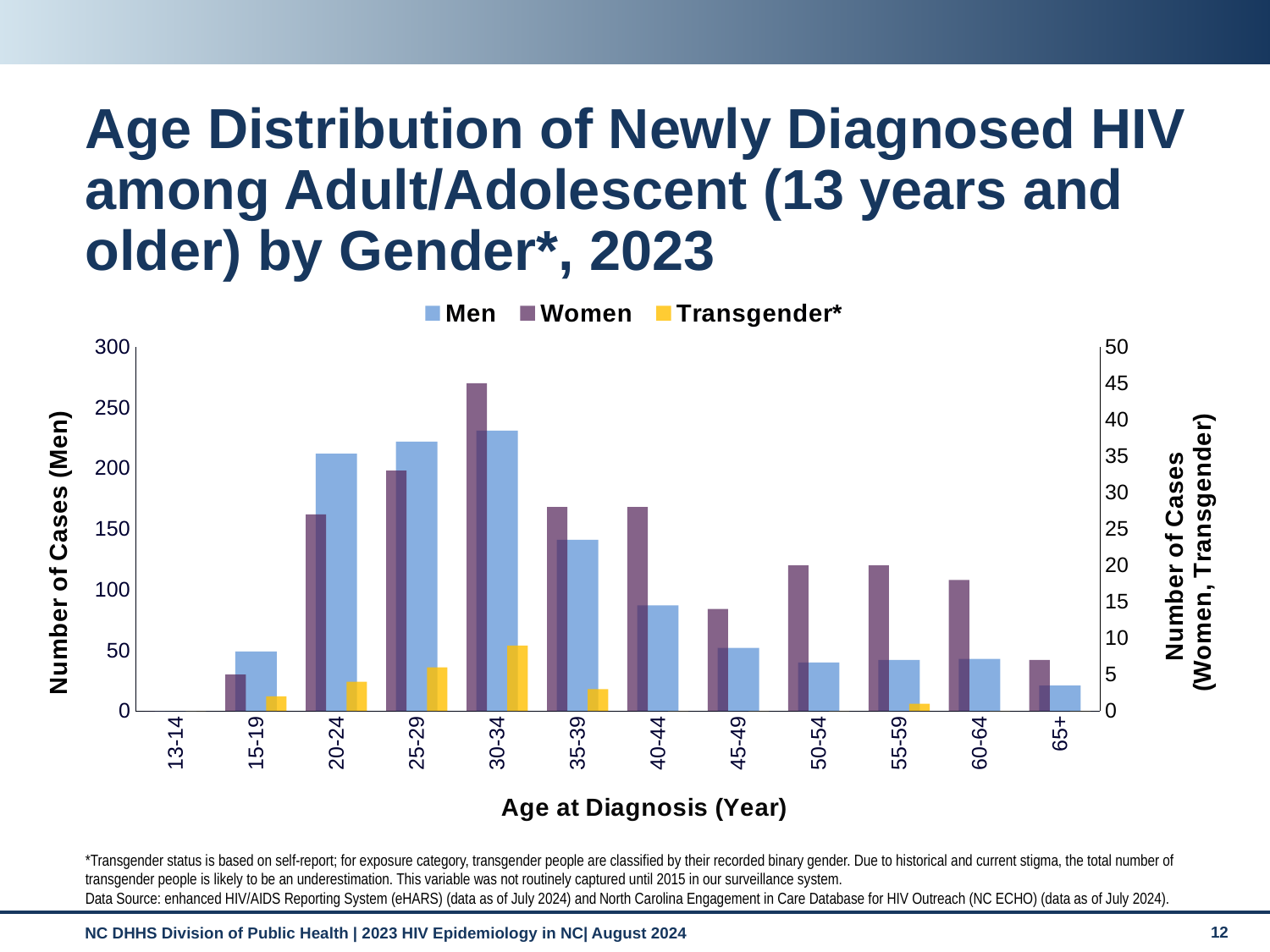
What is the title of the right-hand vertical axis? Number of Cases (Women, Transgender) Is the value for Women in the 30-34 age group greater or less than 40 on the right axis? greater How many series does the legend list? 3 Do the values for Men rise or fall from the 30-34 age group to the 65+ age group? fall Which age group has the highest number of cases for Women? 30-34 Is the value for Men in the 20-24 age group greater or less than 200? greater What kind of chart is shown on the slide? bar chart Which age group has the highest number of cases for Transgender*? 30-34 Is the value for Men in the 40-44 age group greater or less than 100? less How many age categories are shown on the x axis? 12 Which is larger for Men: the 20-24 age group or the 15-19 age group? 20-24 Which age group has the highest number of cases for Men? 30-34